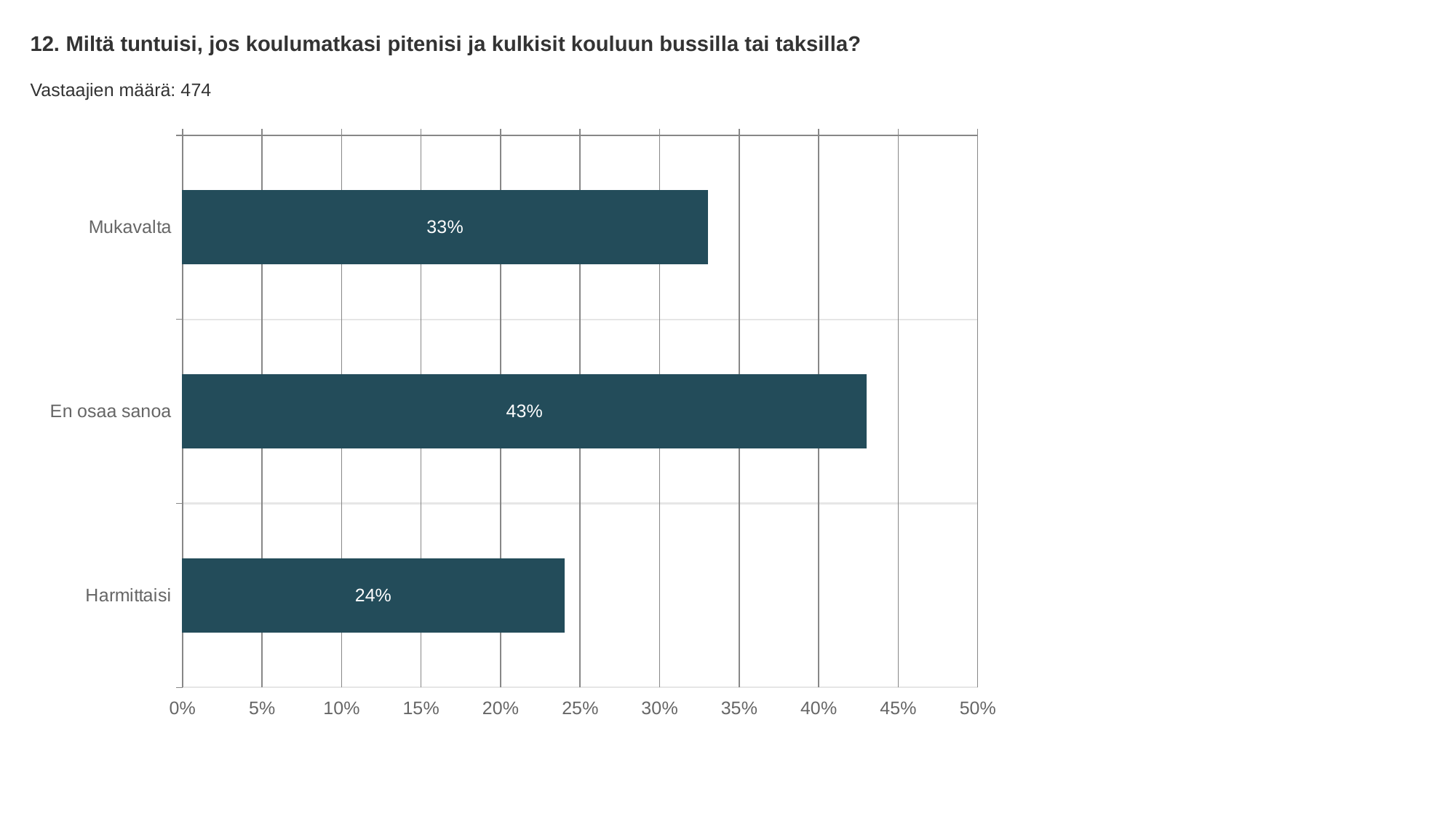
What is the value for Mukavalta? 33% What is the difference between the values for En osaa sanoa and Mukavalta? 10% What kind of chart is shown on the slide? bar chart What is the value for En osaa sanoa? 43% What is the value for Harmittaisi? 24% What is the difference between the values for Mukavalta and Harmittaisi? 9% How many respondents (Vastaajien määrä) are reported on the slide? 474 Which is larger, the value for Mukavalta or the value for Harmittaisi? Mukavalta Is the value for En osaa sanoa greater or less than 40%? greater Which category has the highest value? En osaa sanoa How many categories are shown in the chart? 3 Which category has the lowest value? Harmittaisi